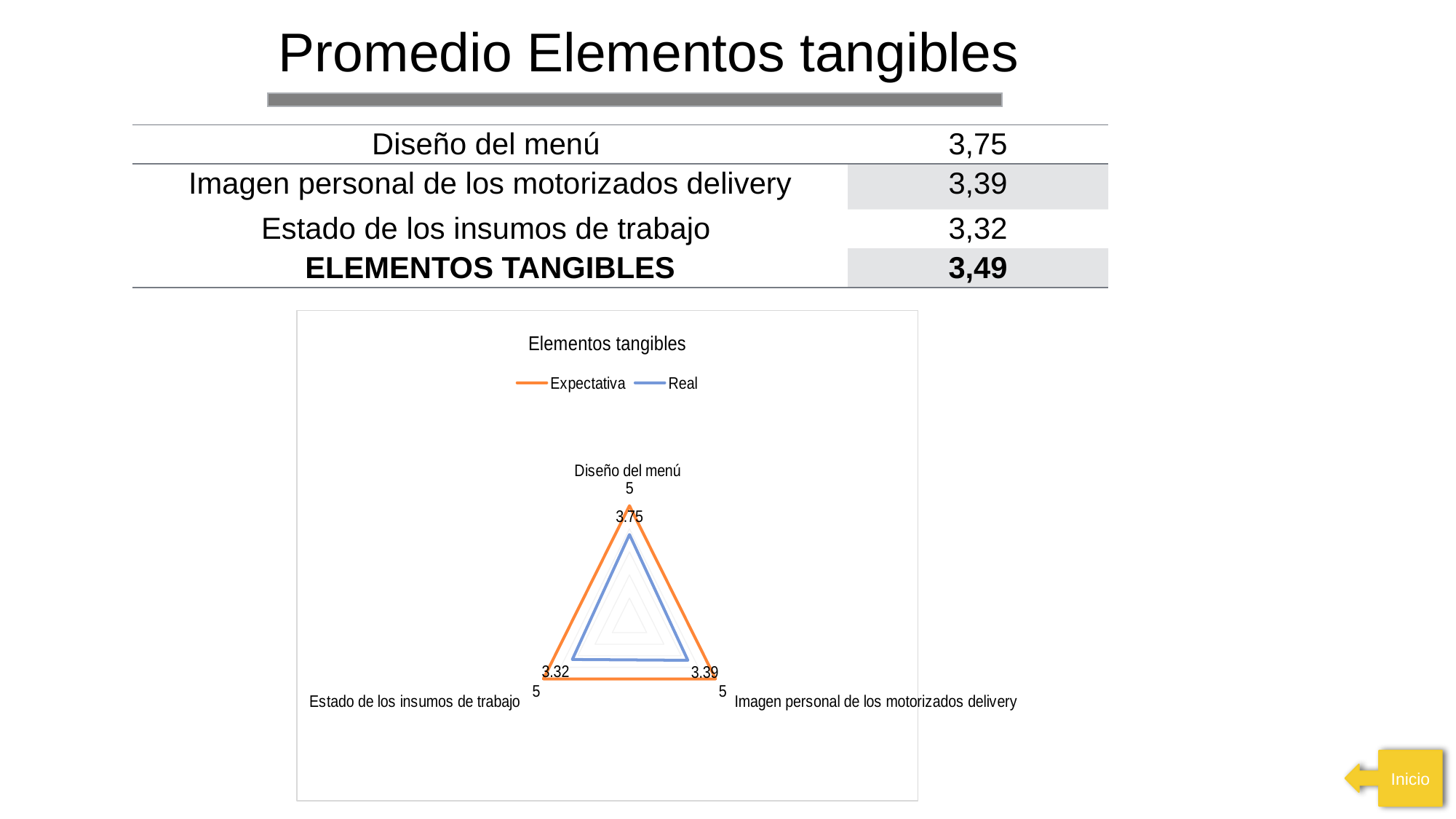
What is the Real value for Estado de los insumos de trabajo? 3.32 Which series is drawn in orange? Expectativa How many series does the chart legend list? 2 What is the Real value for Imagen personal de los motorizados delivery? 3.39 What is the Expectativa value for Diseño del menú? 5 Which category has the lowest Real value? Estado de los insumos de trabajo What is the title of the chart? Elementos tangibles Which category has the highest Real value? Diseño del menú What is the difference between the Expectativa and Real values for Diseño del menú? 1.25 How many categories are plotted on the radar chart? 3 What is the Real value for Diseño del menú? 3.75 What type of chart is shown on the slide? Radar chart